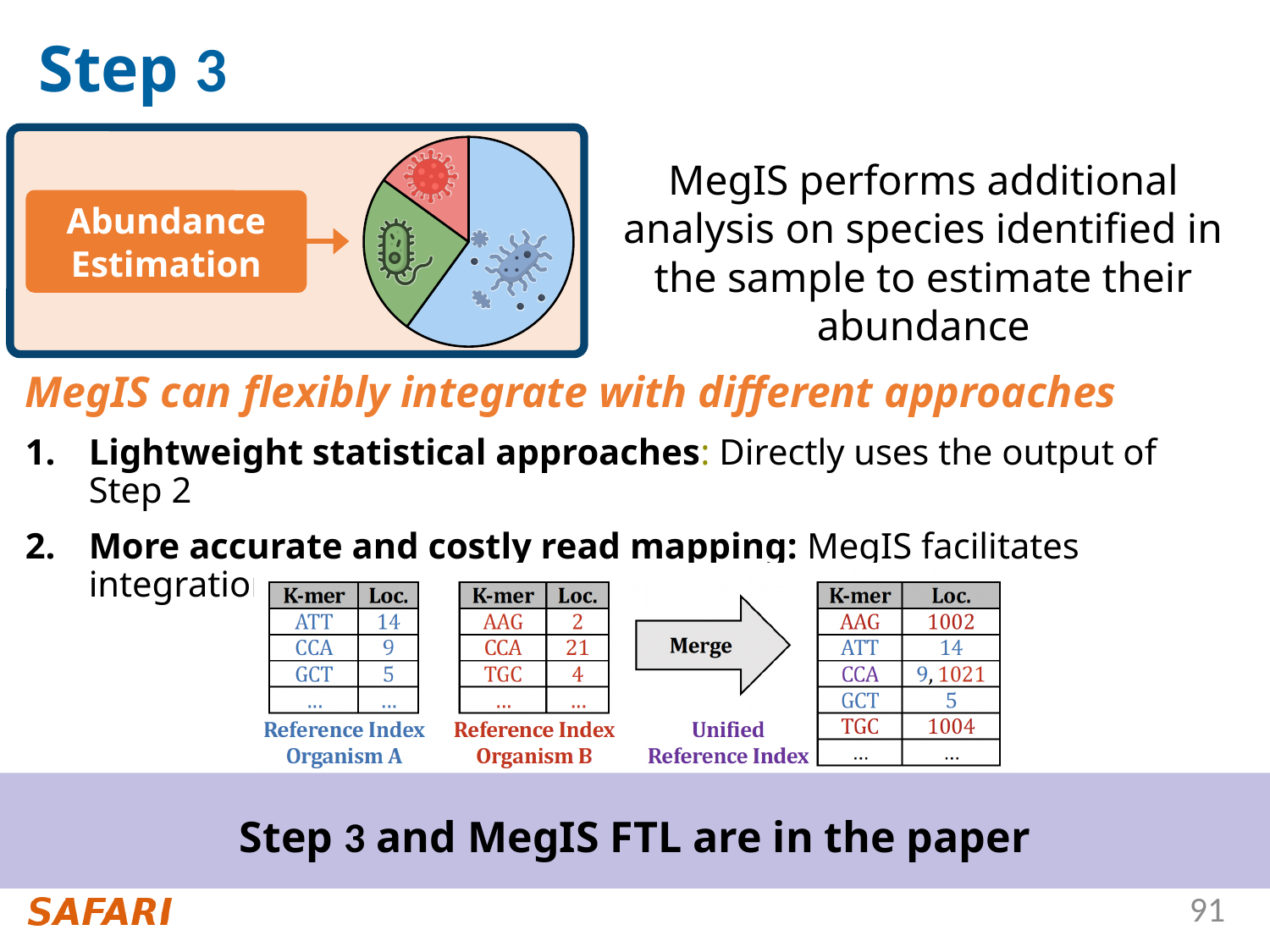
What kind of chart is shown inside the Abundance Estimation box? pie chart Does the pie chart in the Abundance Estimation box show any numeric data labels? No Which colour slice is the largest in the pie chart in the Abundance Estimation box? blue In the pie chart in the Abundance Estimation box, is the green slice larger or smaller than the red slice? larger How many slices does the pie chart in the Abundance Estimation box have? 3 Which colour slice is the smallest in the pie chart in the Abundance Estimation box? red